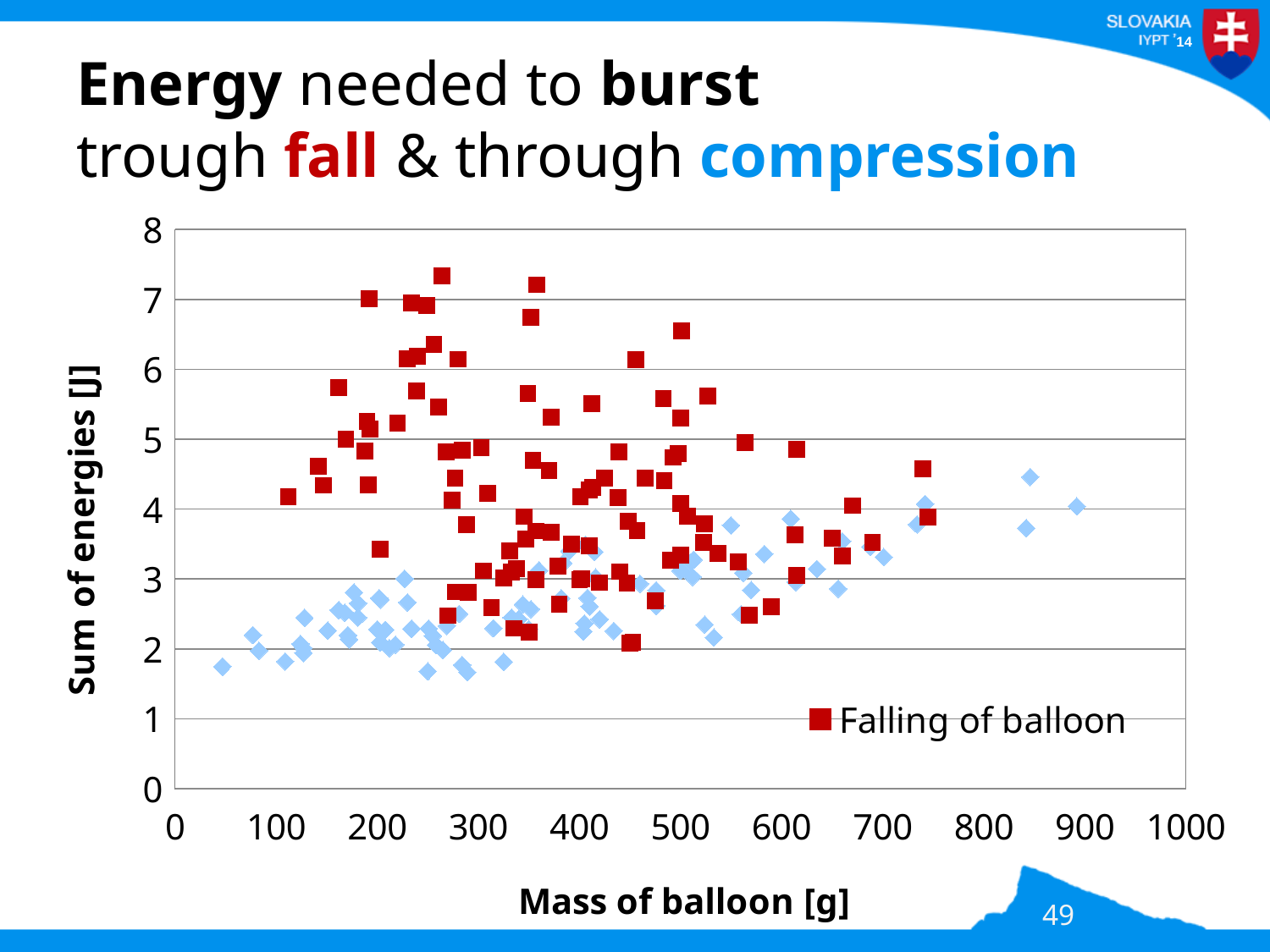
What is the name of the series listed in the chart's legend? Falling of balloon How many series does the chart's legend list? 1 What is the label of the x axis of the chart? Mass of balloon [g] Is the lowest value among the light blue diamond points greater or less than 2 J? less Do the red 'Falling of balloon' points generally rise or fall as the mass of the balloon increases? fall Is the lowest value among the red 'Falling of balloon' points greater or less than 3 J? less Is the highest value among the red 'Falling of balloon' points greater or less than 7 J? greater Do the light blue diamond points generally rise or fall as the mass of the balloon increases? rise Which series reaches higher energy values overall, the red 'Falling of balloon' squares or the light blue diamonds? Falling of balloon (red squares) What kind of chart is shown on the slide? Scatter chart